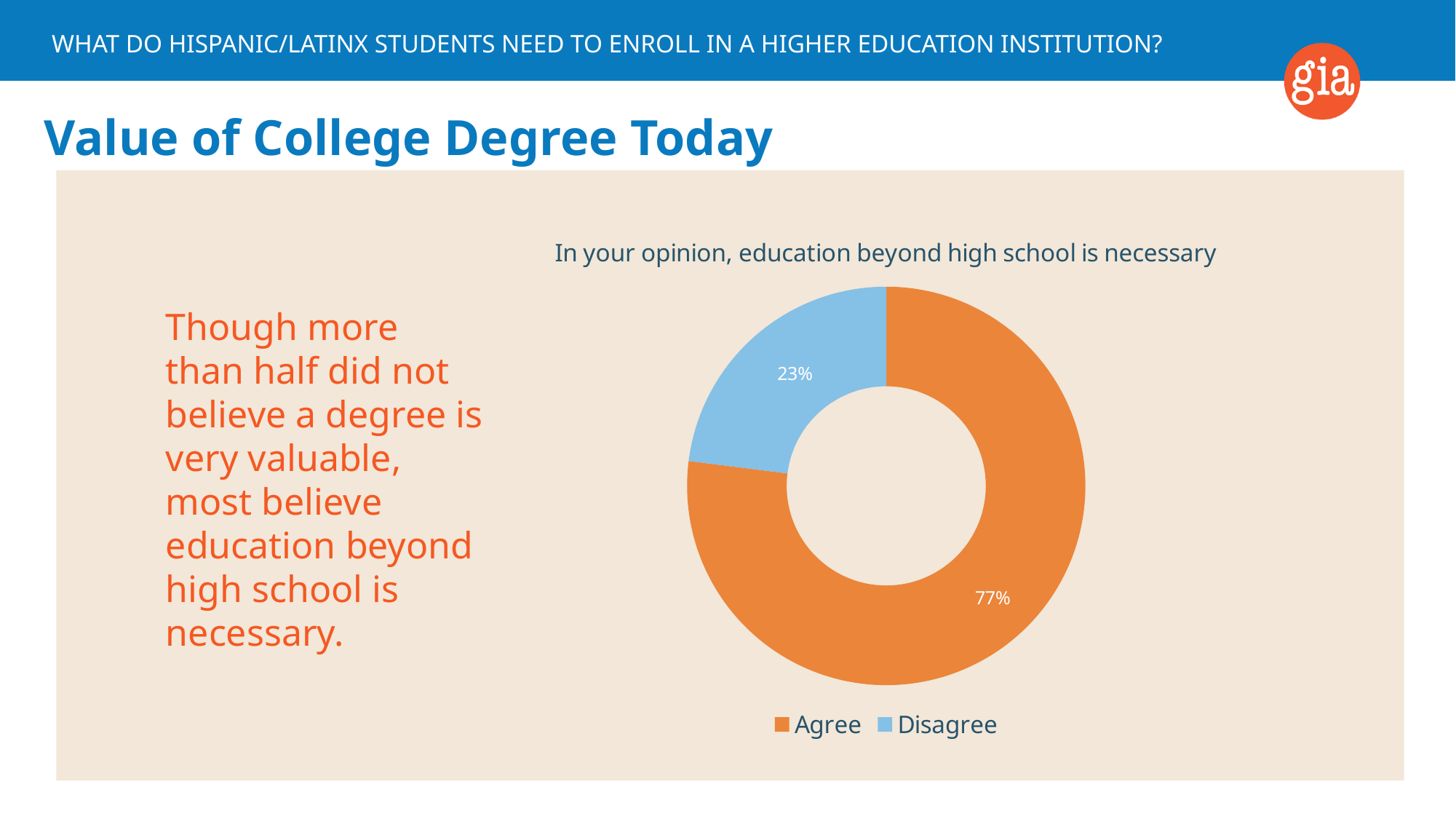
Is the share for Agree larger or smaller than the share for Disagree? larger Which response has the larger share of the chart, Agree or Disagree? Agree What percentage of respondents disagree that education beyond high school is necessary? 23% What kind of chart is shown on the slide? Doughnut (pie) chart What is the title of the chart? In your opinion, education beyond high school is necessary Which colour represents Disagree in the chart? Light blue How many entries does the legend list? 2 What share of the chart does the Agree slice represent? 77% What percentage of respondents agree that education beyond high school is necessary? 77% How many categories does the chart show? 2 Which response has the smallest share of the chart? Disagree What is the difference in percentage points between the Agree and Disagree shares? 54